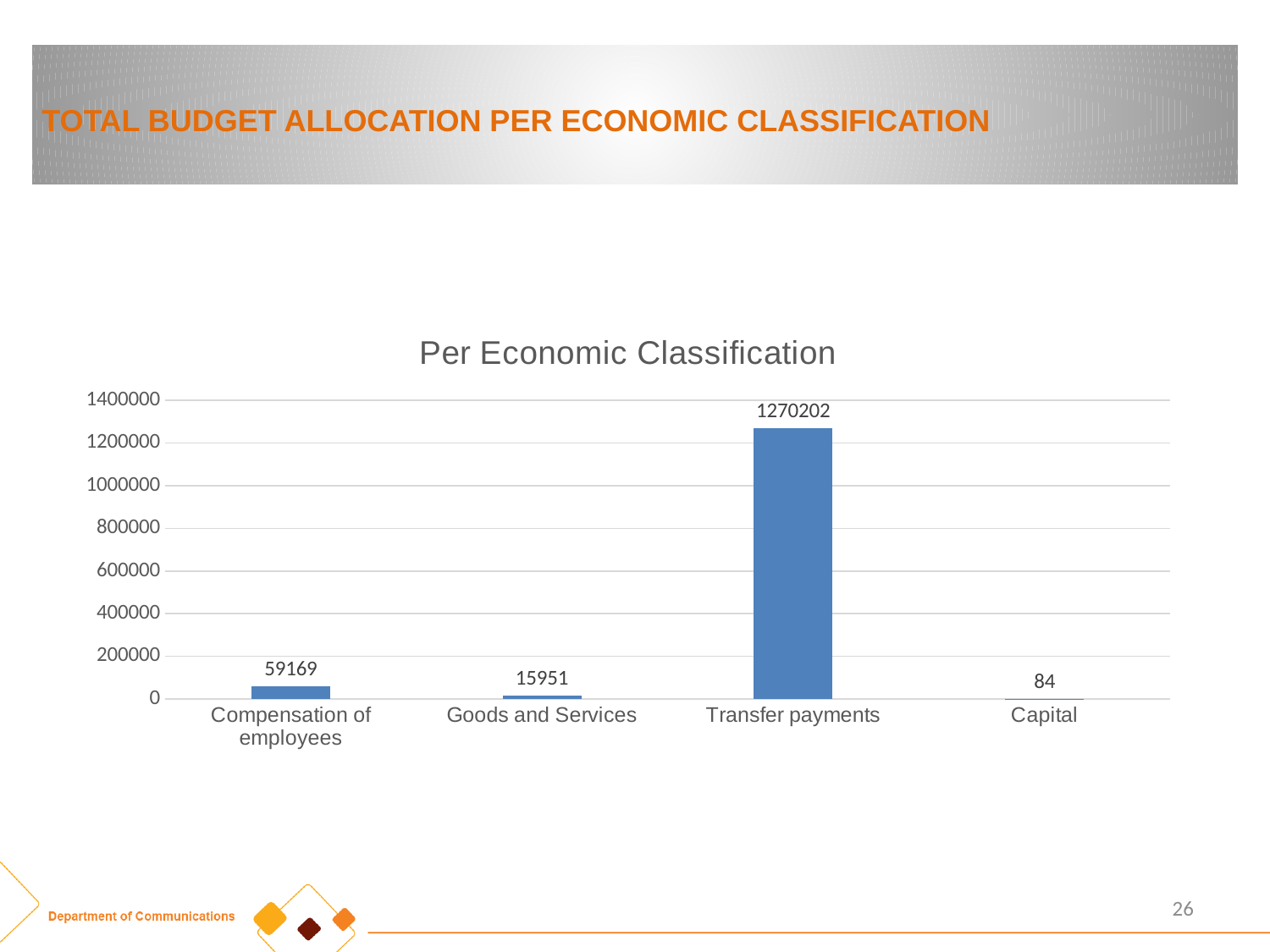
What is the value for Goods and Services? 15951 What is the title of the chart? Per Economic Classification Which category has the lowest value? Capital What is the value for Compensation of employees? 59169 What is the value for Capital? 84 What kind of chart is shown? Bar chart How many categories are shown on the x axis? 4 Which category has the highest value? Transfer payments Is the value for Transfer payments greater or less than 1200000? greater Which is larger, the value for Compensation of employees or the value for Goods and Services? Compensation of employees What is the difference between the values for Compensation of employees and Goods and Services? 43218 What is the value for Transfer payments? 1270202